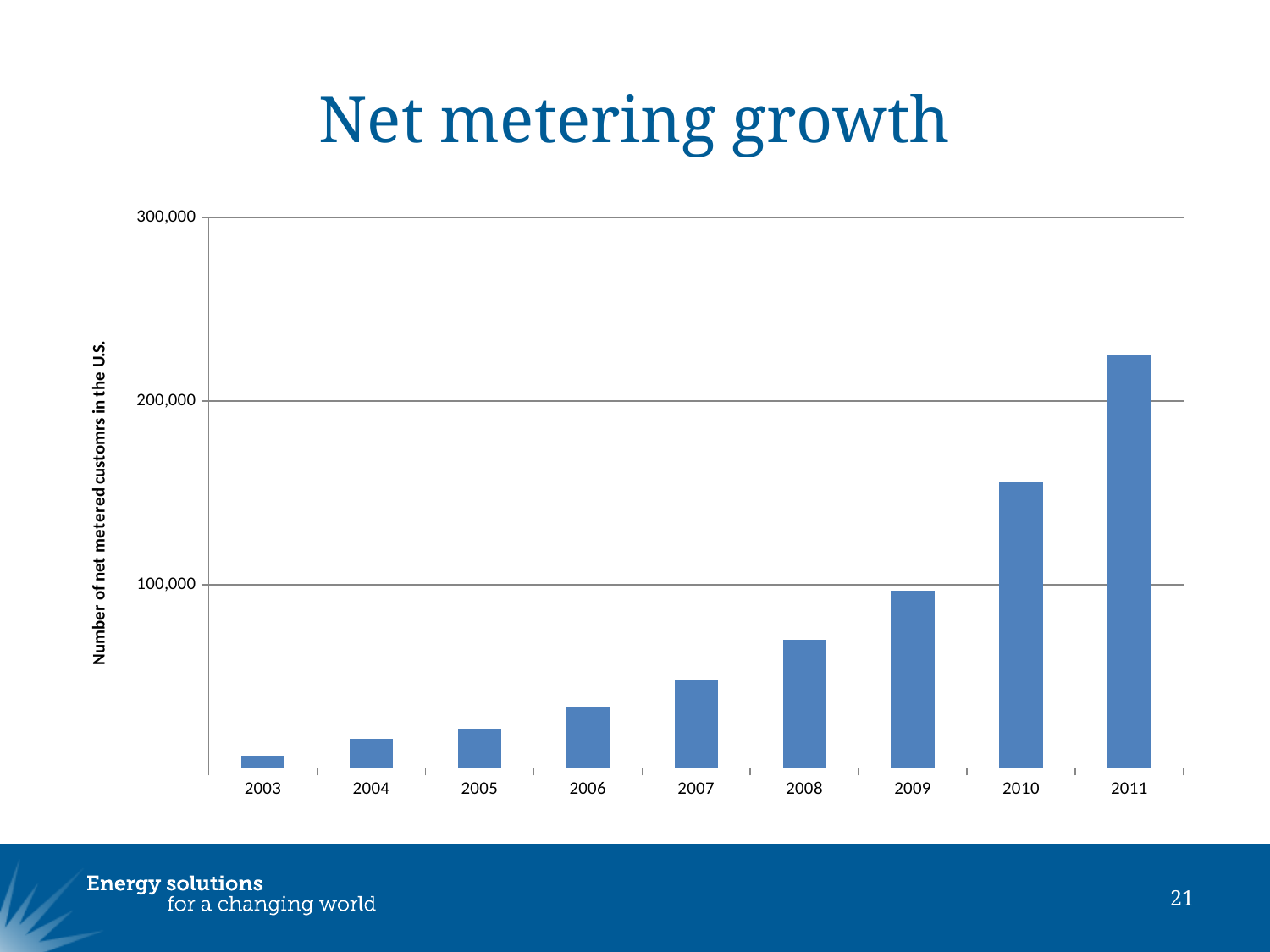
What is the label on the vertical axis of the chart? Number of net metered customrs in the U.S. Do the values rise or fall from 2003 to 2011? rise Which is larger, the value for 2010 or the value for 2008? 2010 Which year has the highest number of net metered customers? 2011 How many years are shown on the x axis of the chart? 9 What kind of chart is shown on the slide? bar chart Is the value for 2010 greater or less than 100,000? greater Which year has the lowest number of net metered customers? 2003 Is the value for 2010 greater or less than 200,000? less Is the value for 2008 greater or less than 100,000? less What is the title of the chart? Net metering growth